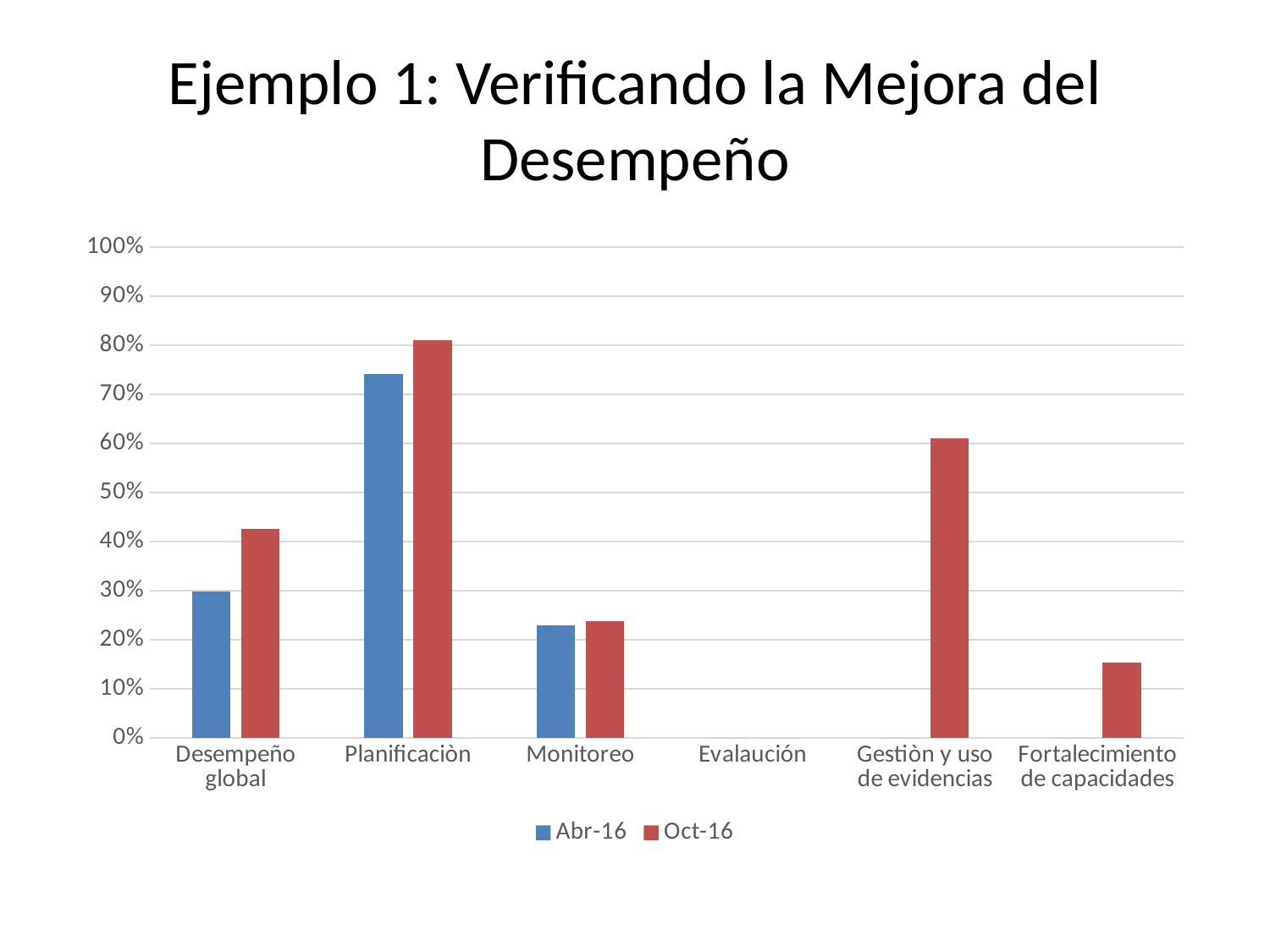
Is the Oct-16 value for Gestiòn y uso de evidencias greater or less than 50%? greater Is the Abr-16 value for Desempeño global greater or less than 40%? less What kind of chart is shown on the slide? bar chart Which category has the highest Abr-16 value? Planificaciòn Is the Oct-16 value for Fortalecimiento de capacidades greater or less than 20%? less Which is larger: the Oct-16 value for Gestiòn y uso de evidencias or the Oct-16 value for Desempeño global? Gestiòn y uso de evidencias Which category has the highest Oct-16 value? Planificaciòn How many categories are shown on the x axis? 6 What are the two series named in the legend? Abr-16 and Oct-16 How many series does the legend list? 2 For Desempeño global, which is larger: the Abr-16 value or the Oct-16 value? Oct-16